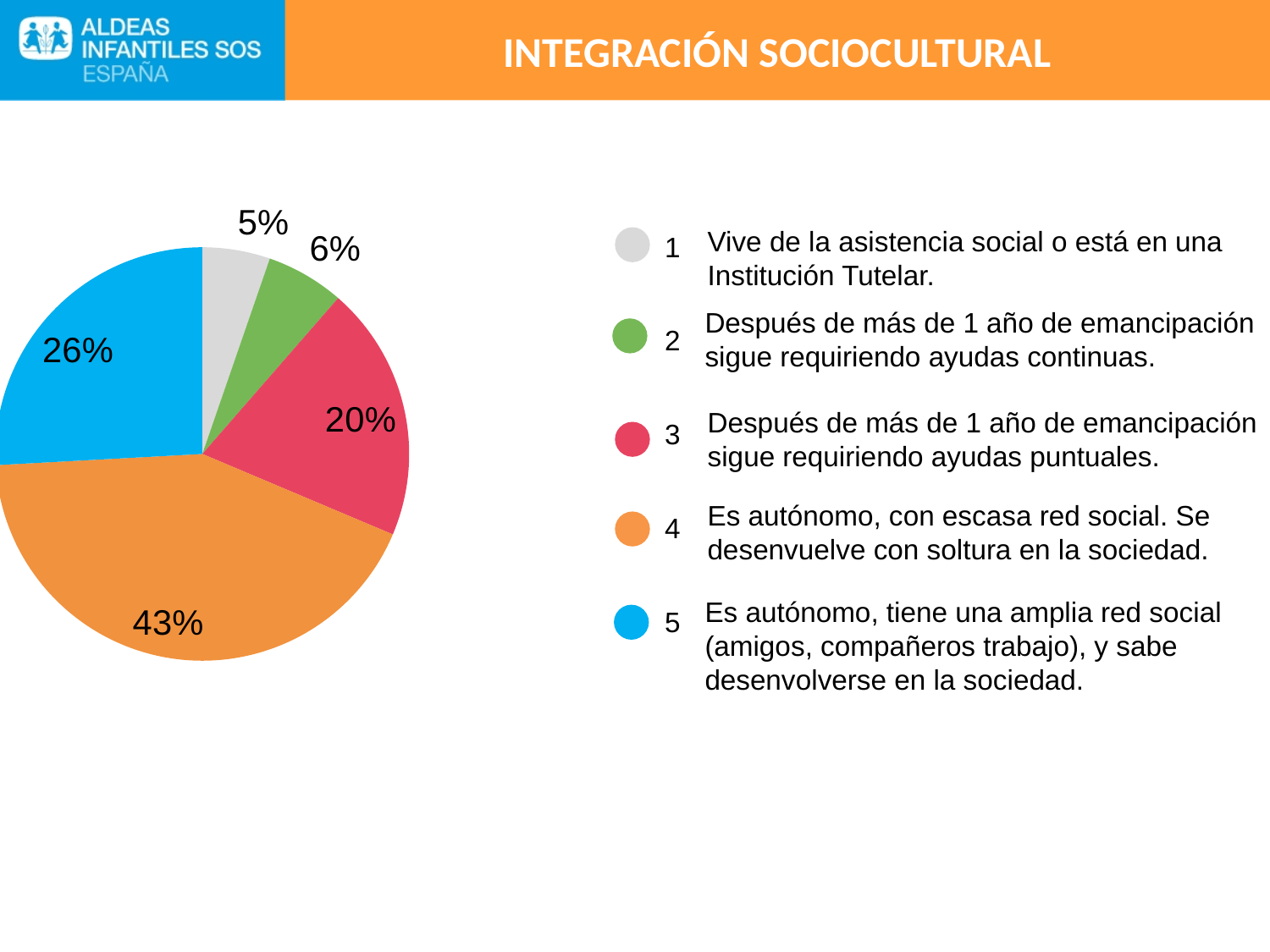
Which category has the largest share of the pie? 4 (Es autónomo, con escasa red social) What percentage does the red slice (category 3, 'sigue requiriendo ayudas puntuales') represent? 20% What percentage does the blue slice (category 5, 'Es autónomo, tiene una amplia red social') represent? 26% What is the difference in percentage points between the orange slice (43%) and the blue slice (26%)? 17 How many slices does the pie chart have? 5 What percentage does the grey slice (category 1, 'Vive de la asistencia social') represent? 5% What percentage does the orange slice (category 4, 'Es autónomo, con escasa red social') represent? 43% What percentage does the green slice (category 2, 'sigue requiriendo ayudas continuas') represent? 6% What kind of chart is shown on the slide? pie chart Which category has the smallest share of the pie? 1 (Vive de la asistencia social o está en una Institución Tutelar) What colour is the slice for category 2 in the legend? green Which is larger, the share for category 3 (red) or the share for category 5 (blue)? category 5 (blue), 26%